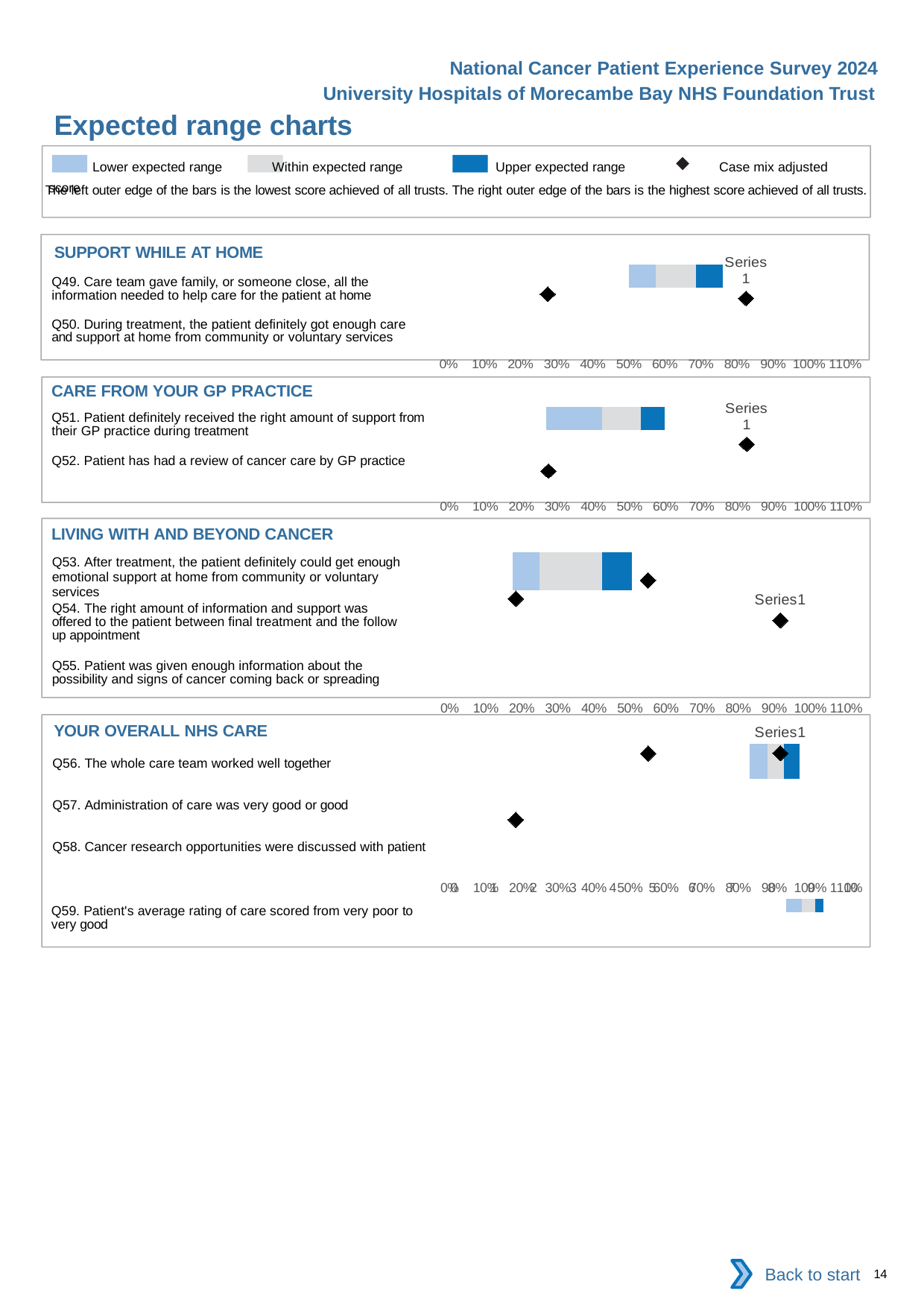
How many questions are listed in the LIVING WITH AND BEYOND CANCER chart? 3 In the CARE FROM YOUR GP PRACTICE chart, is the left edge of the expected range bar greater or less than 40%? less How many section charts are shown on the slide? 4 What symbol represents the case mix adjusted score in the legend? A black diamond What is the highest value shown on the x axis of the SUPPORT WHILE AT HOME chart? 110% What kind of chart is used in the SUPPORT WHILE AT HOME section? Bar chart How many questions are listed in the CARE FROM YOUR GP PRACTICE chart? 2 Which legend entry is shown in dark blue? Upper expected range How many entries does the legend at the top of the slide list? 4 In the SUPPORT WHILE AT HOME chart, is the right edge of the expected range bar greater or less than 60%? greater